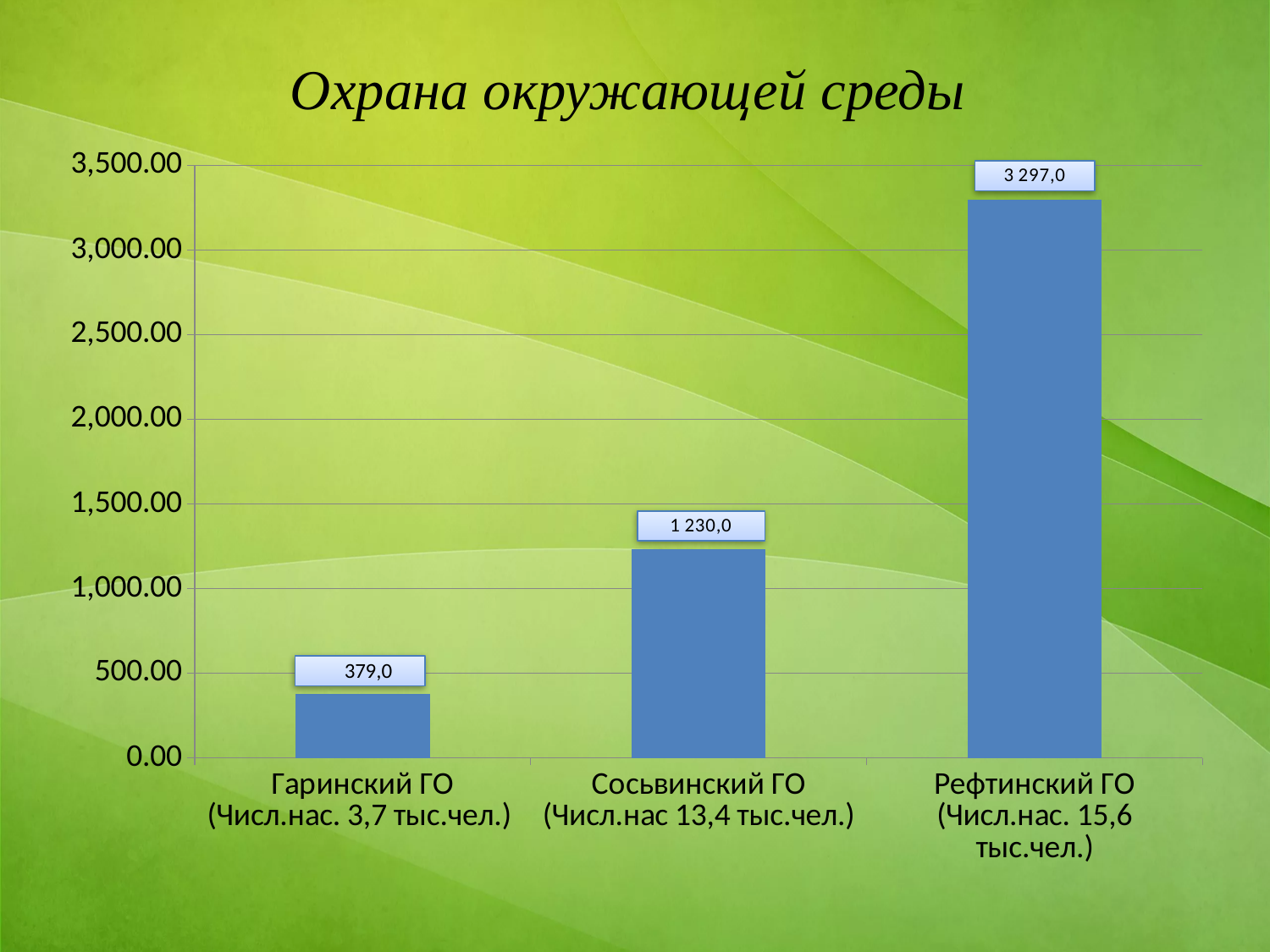
What is the difference between the values for Рефтинский ГО and Сосьвинский ГО? 2 067,0 Which is larger, the value for Сосьвинский ГО or the value for Гаринский ГО? Сосьвинский ГО What is the value for Рефтинский ГО? 3 297,0 What kind of chart is shown on the slide? bar chart How many categories are shown in the chart? 3 Which category has the lowest value? Гаринский ГО Is the value for Сосьвинский ГО greater or less than 1,500.00? less What is the difference between the values for Сосьвинский ГО and Гаринский ГО? 851,0 What is the value for Сосьвинский ГО? 1 230,0 Which category has the highest value? Рефтинский ГО What is the title of the slide? Охрана окружающей среды What is the value for Гаринский ГО? 379,0